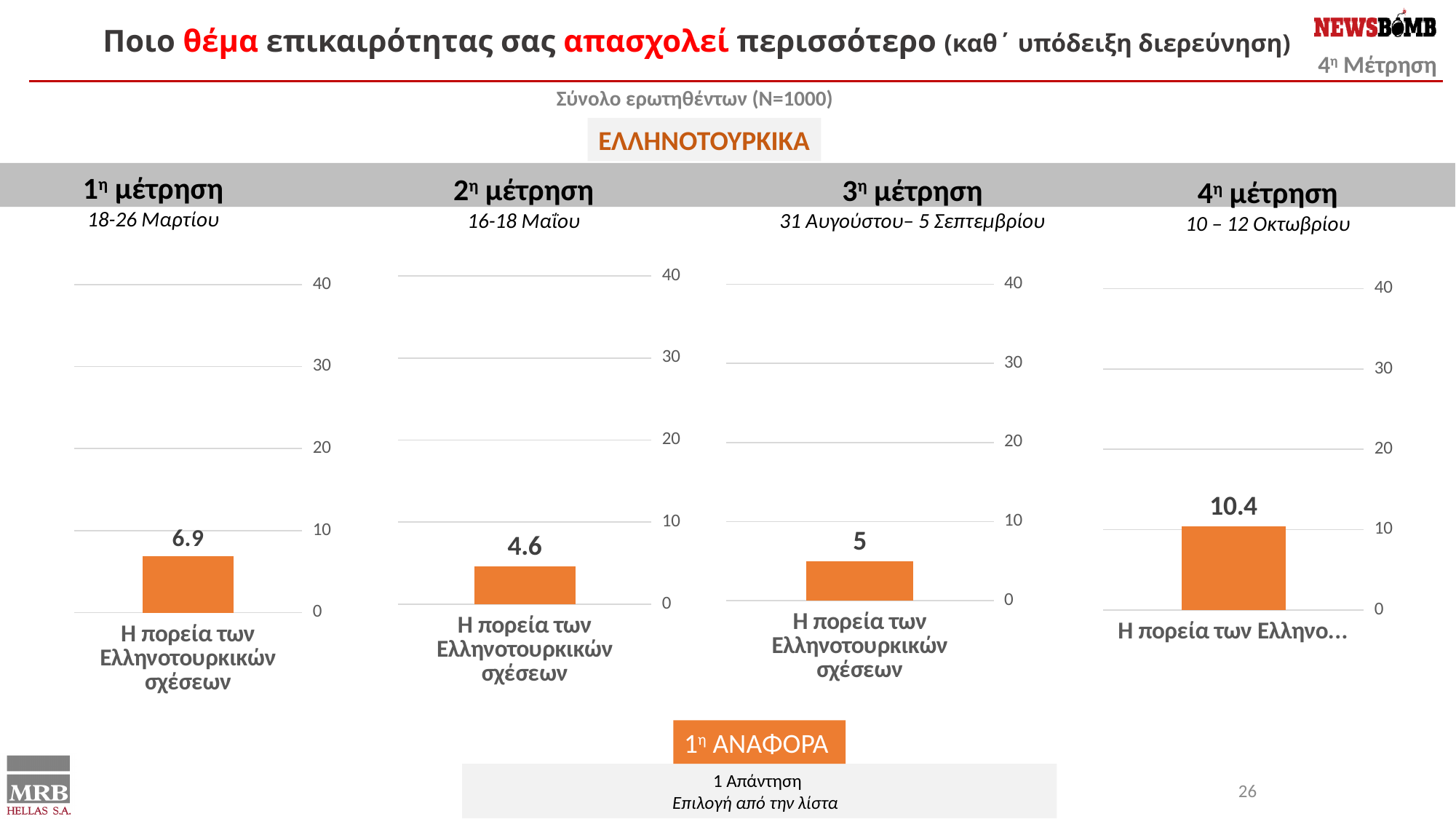
In the chart for the 4η μέτρηση (10 – 12 Οκτωβρίου), what value is printed on the bar? 10.4 What is the difference between the value in the 4η μέτρηση chart and the value in the 1η μέτρηση chart? 3.5 How many bars does the chart for the 1η μέτρηση contain? 1 In the chart for the 3η μέτρηση (31 Αυγούστου – 5 Σεπτεμβρίου), what value is printed on the bar? 5 In the chart for the 1η μέτρηση (18-26 Μαρτίου), what is the value of the bar for Η πορεία των Ελληνοτουρκικών σχέσεων? 6.9 In the chart for the 2η μέτρηση (16-18 Μαΐου), what value is printed on the bar? 4.6 Across the four charts, which measurement shows the highest value for Η πορεία των Ελληνοτουρκικών σχέσεων? 4η μέτρηση What kind of chart is used for each of the four measurements on the slide? bar chart Across the four charts, which measurement shows the lowest value for Η πορεία των Ελληνοτουρκικών σχέσεων? 2η μέτρηση Which is larger: the value in the 3η μέτρηση chart or the value in the 2η μέτρηση chart? 3η μέτρηση What is the maximum value shown on the vertical axis of the 2η μέτρηση chart? 40 In the 4η μέτρηση chart, is the value of the bar greater or less than 10? greater